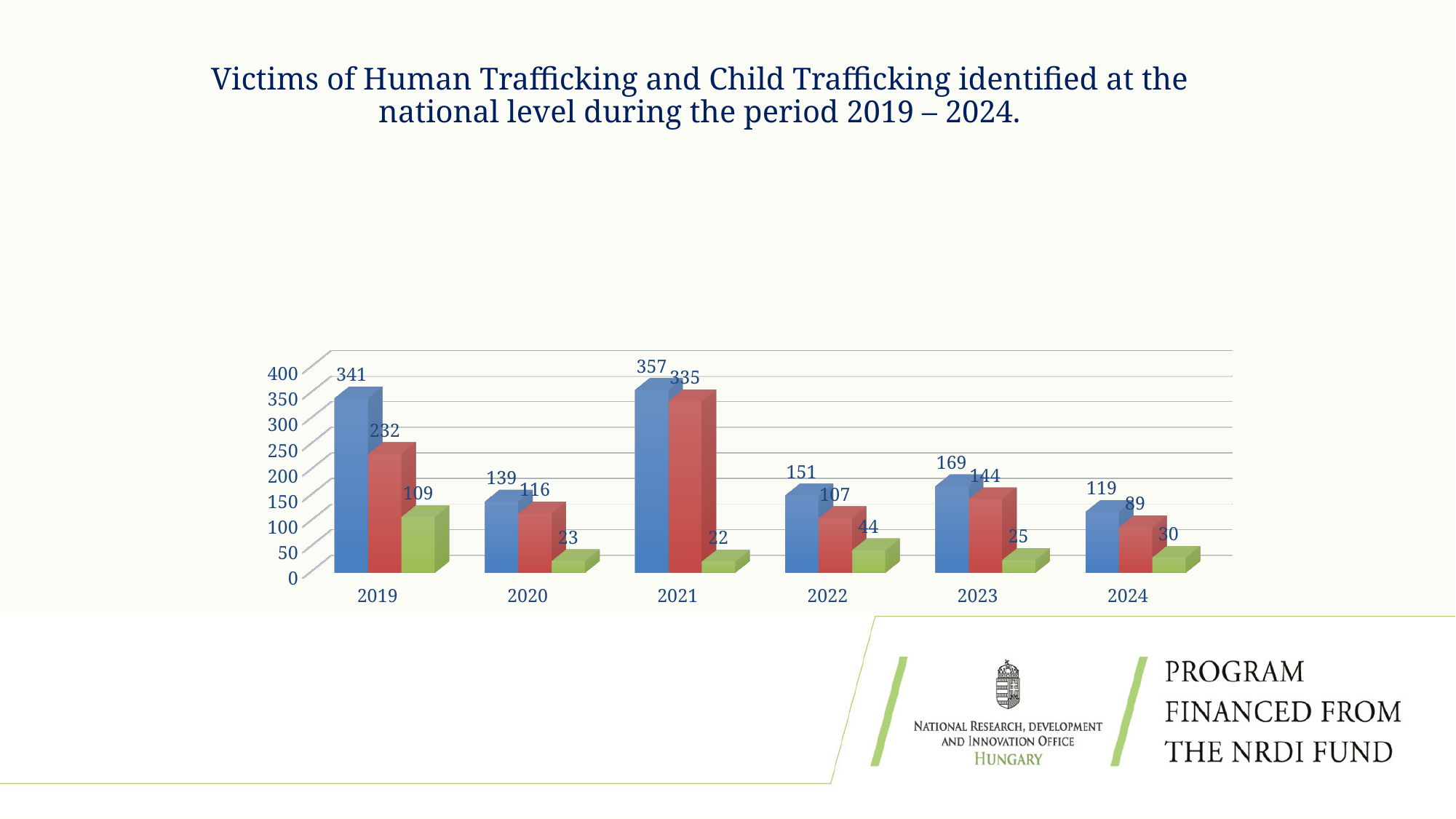
Which is larger, the red bar for 2020 or the red bar for 2022? 2020 What is the value of the blue bar for 2021? 357 Does the blue bar rise or fall from 2021 to 2024? fall What is the value of the green bar for 2019? 109 Is the value of the blue bar for 2023 greater or less than 150? greater How many years are shown on the x axis? 6 What kind of chart is shown on the slide? bar chart How many bars are shown for each year? 3 What is the difference between the blue bar and the red bar in 2019? 109 In which year is the green bar lowest? 2021 In which year is the blue bar highest? 2021 What is the value of the red bar for 2024? 89